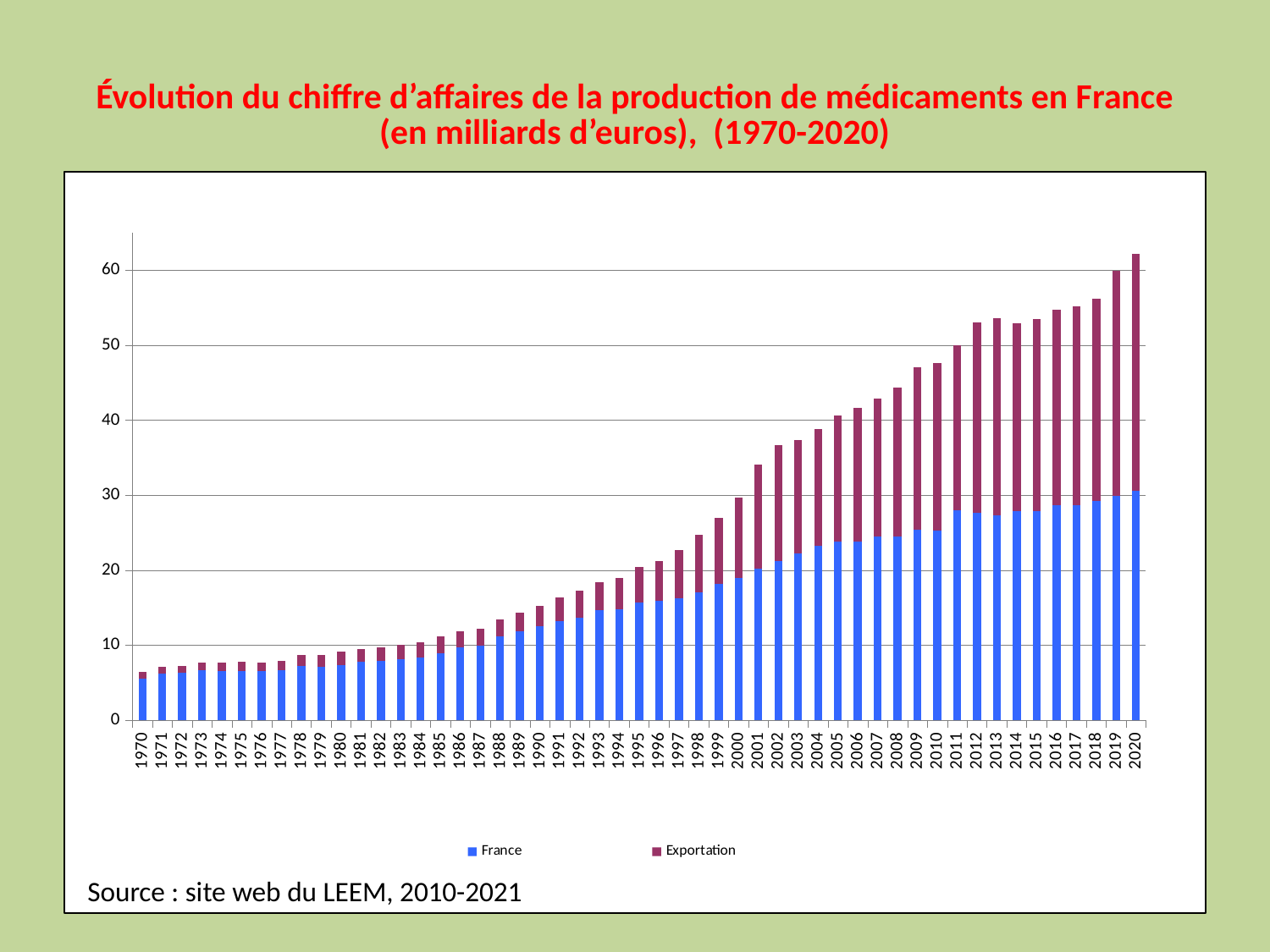
Is the France value for 2011 greater or less than 20? greater What kind of chart is shown on the slide? Stacked bar chart How many years are shown along the x axis? 51 In 1970, which series is larger, France or Exportation? France Is the total value for 2010 greater or less than 40? greater Which year has the lowest total bar? 1970 Do the total values rise or fall from 1970 to 2020? Rise How many series does the legend list? 2 Which colour represents the Exportation series? Purple (dark red) What are the two series named in the legend? France and Exportation Is the total value for 1980 greater or less than 10? less Which year has the highest total bar? 2020